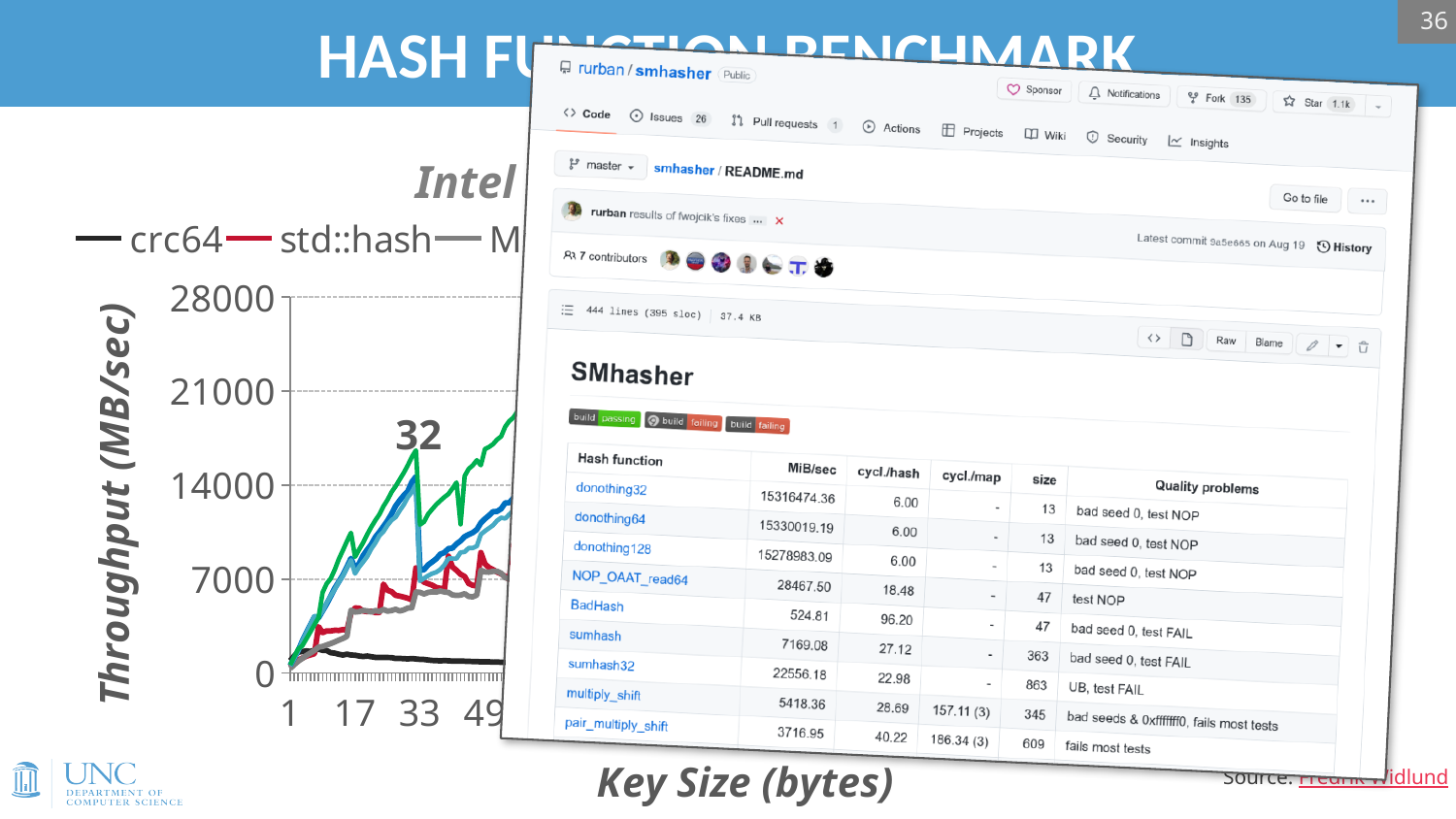
What is the first tick value shown on the x axis of the chart? 1 What is the highest tick value shown on the y axis of the chart? 28000 What is the label of the y axis of the chart? Throughput (MB/sec) Is the throughput for crc64 at key size 17 greater or less than 7000? less What kind of chart is shown on the slide? line chart Is the throughput for crc64 at key size 49 greater or less than 7000? less Which series has the higher throughput at key size 33, crc64 or std::hash? std::hash What is the label of the x axis of the chart? Key Size (bytes) Is the throughput for std::hash at key size 17 greater or less than 7000? less